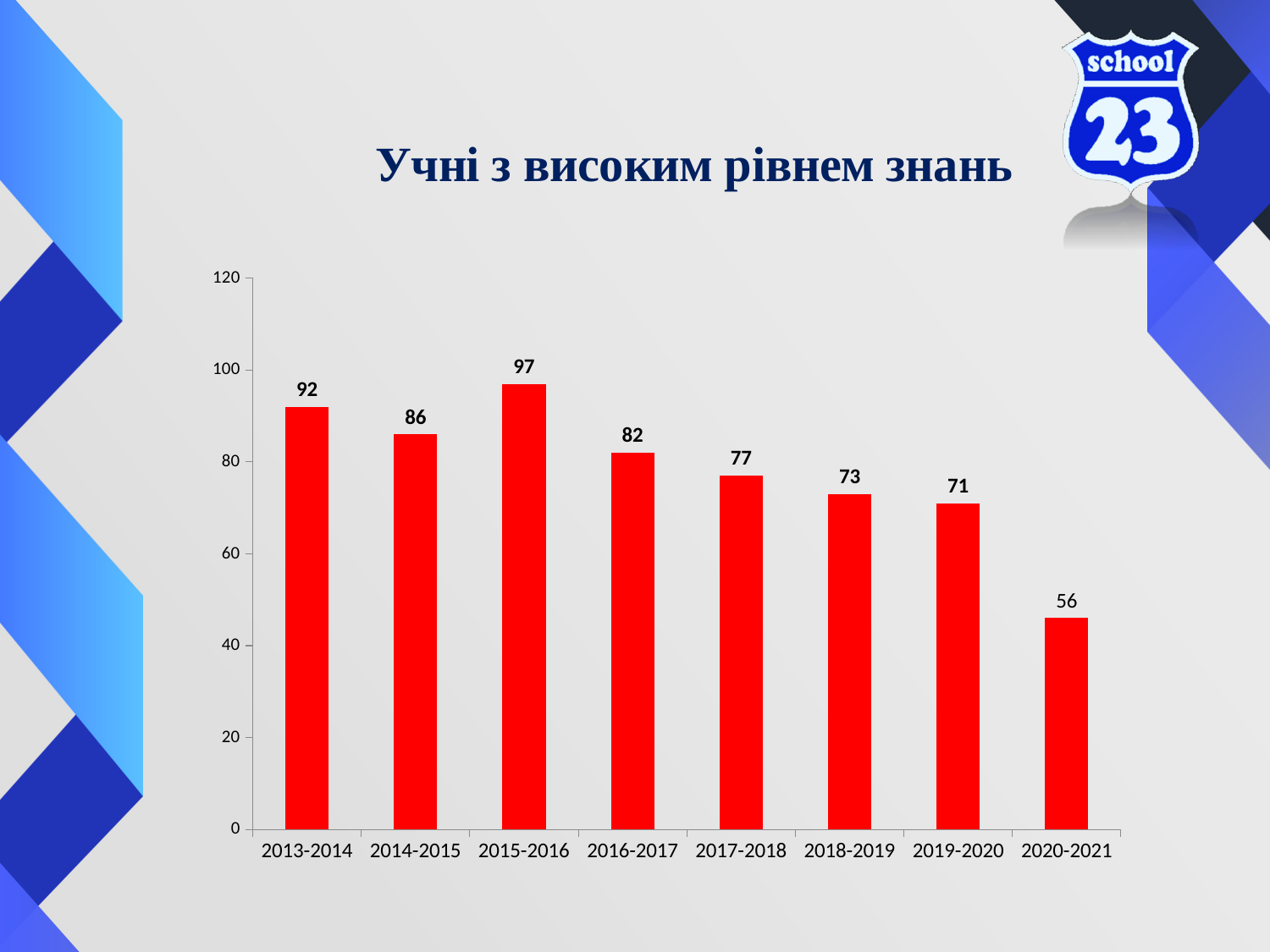
Which is larger, the value for 2016-2017 or the value for 2018-2019? 2016-2017 How many school years are shown on the x axis? 8 Is the value for 2019-2020 greater or less than 80? less What kind of chart is shown on the slide? bar chart Which school year has the lowest value? 2020-2021 Which school year has the highest value? 2015-2016 What is the value for 2020-2021? 56 What is the title of the slide? Учні з високим рівнем знань What is the value for 2015-2016? 97 What is the value for 2017-2018? 77 What is the difference between the values for 2013-2014 and 2014-2015? 6 What is the difference between the values for 2015-2016 and 2020-2021? 41